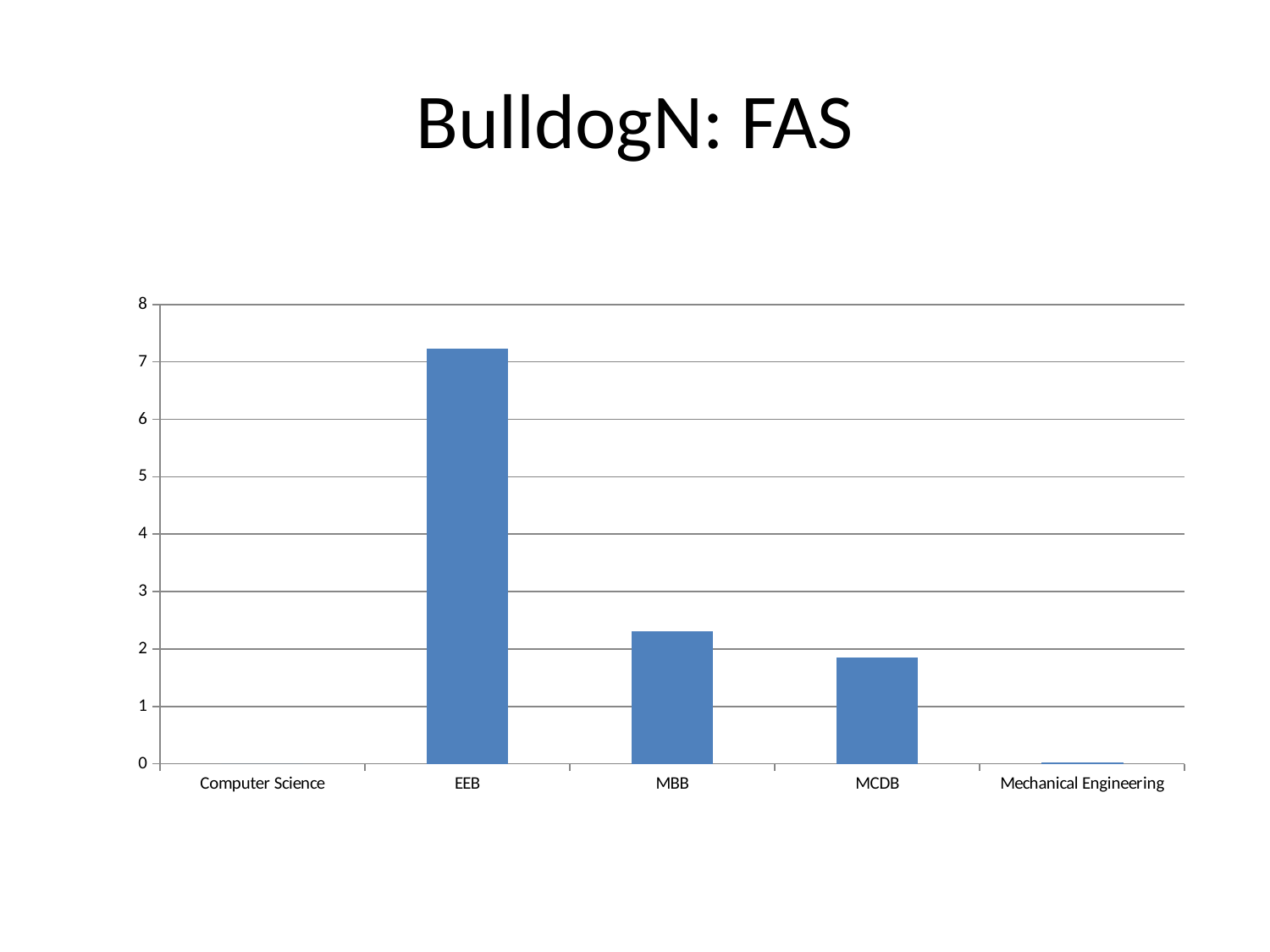
What kind of chart is shown on the slide? bar chart Which category has the highest value in the chart? EEB Is the value for MCDB greater or less than 1? greater Is the value for MBB greater or less than 2? greater Is the value for MCDB greater or less than 2? less What is the title of the slide containing the chart? BulldogN: FAS Which has the larger value, EEB or MBB? EEB Which has the larger value, MBB or MCDB? MBB How many categories are shown on the x axis of the chart? 5